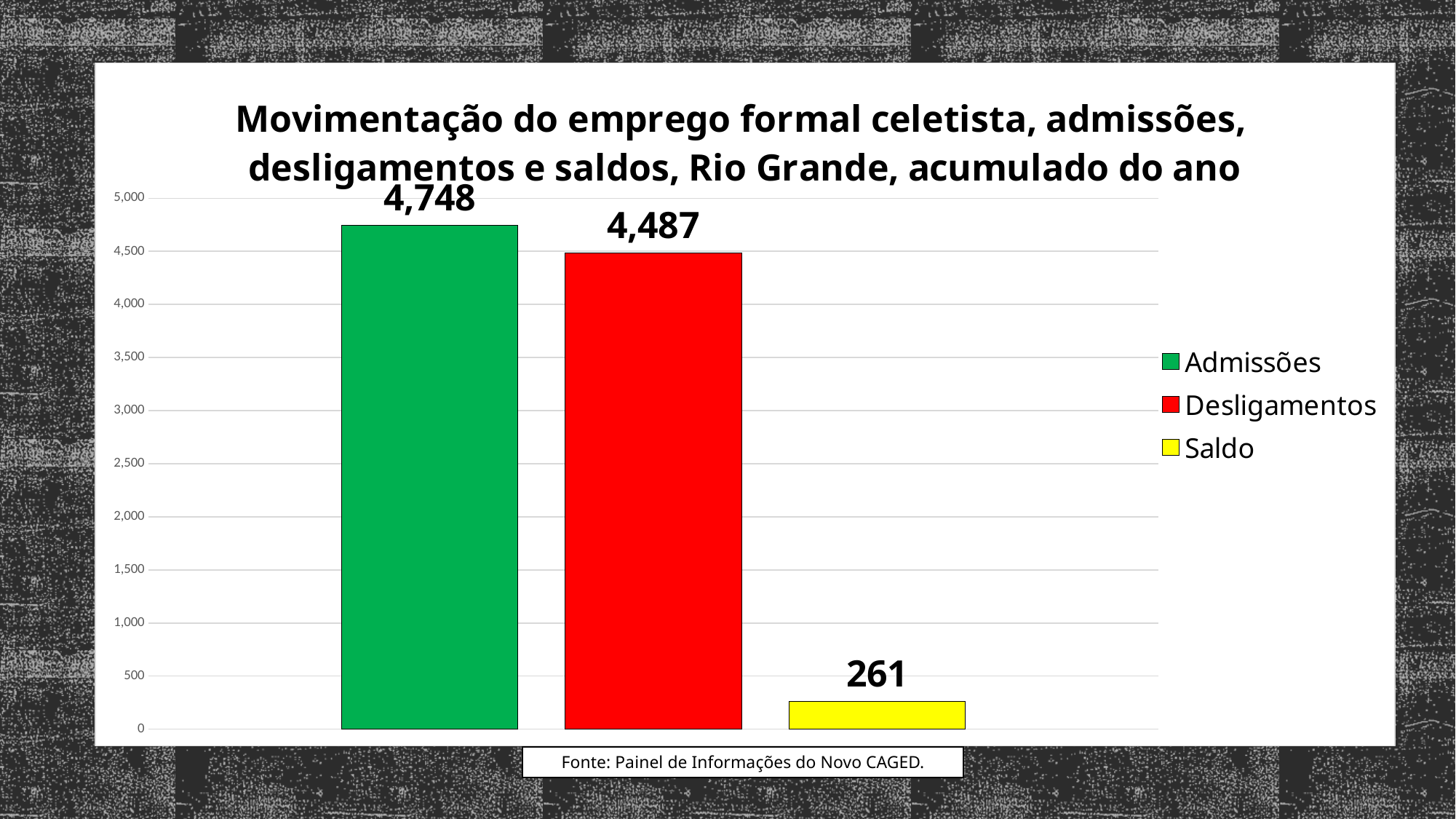
What colour is the bar for Saldo? yellow What is the difference between Admissões and Desligamentos? 261 How many series does the legend list? 3 Which series has the lowest value? Saldo Which is larger, Admissões or Desligamentos? Admissões What kind of chart is shown? bar chart What is the value for Saldo? 261 What is the value for Admissões? 4,748 What is the value for Desligamentos? 4,487 Is the value for Saldo greater or less than 500? less Is the value for Desligamentos greater or less than 4,500? less Which series has the highest value? Admissões